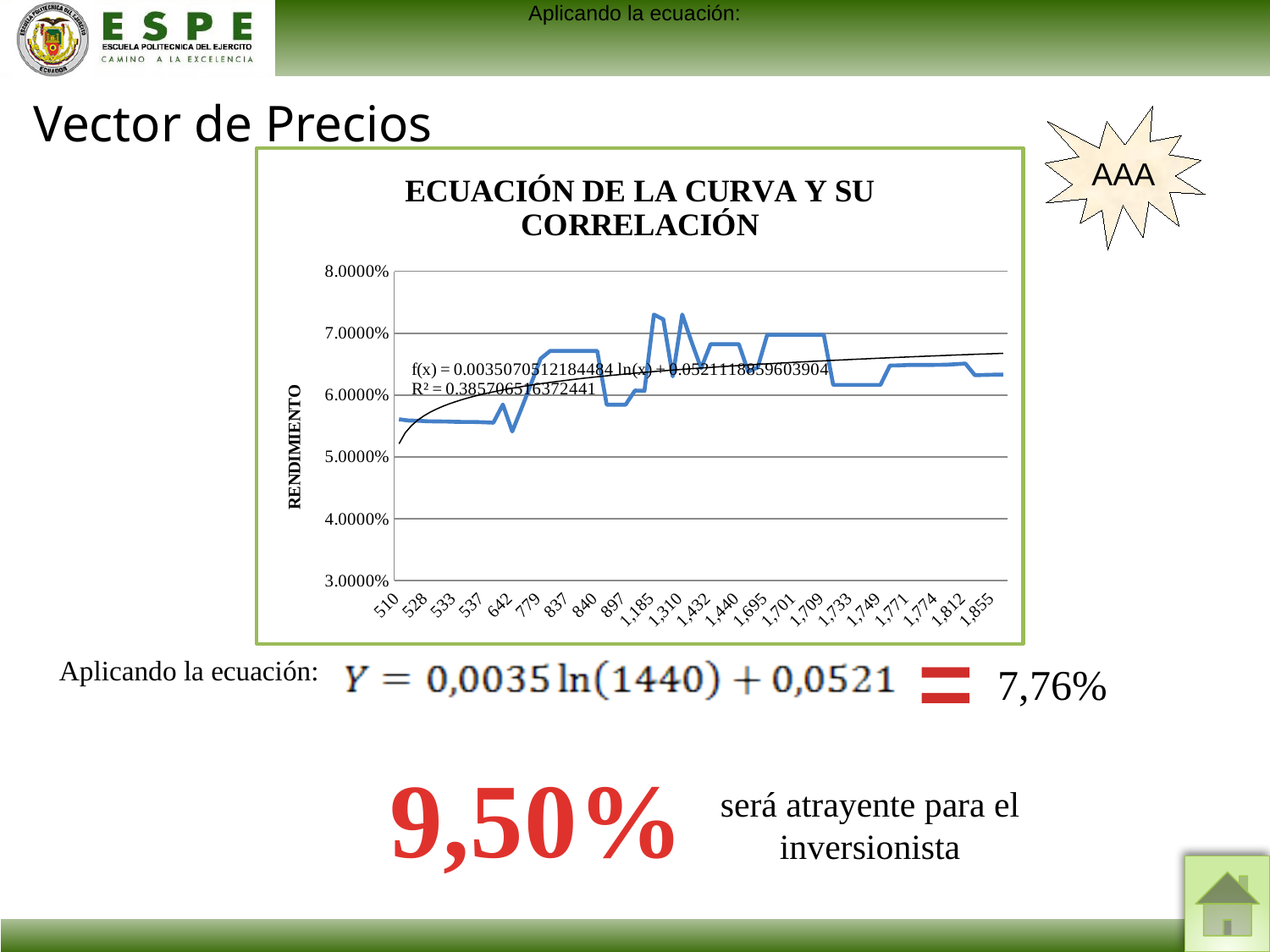
What kind of chart is shown on the slide? line chart What is the title of the chart? ECUACIÓN DE LA CURVA Y SU CORRELACIÓN Is the value for 897 greater or less than 6.0000%? less What R² value is printed on the chart? 0.385706516372441 What is the highest tick value shown on the vertical axis? 8.0000% What is the label of the vertical axis of the chart? RENDIMIENTO Is the value for 1,855 greater or less than 6.0000%? greater Is the value for 1,855 greater or less than 7.0000%? less Which has the larger value, 510 or 1,855? 1,855 Do the values generally rise or fall along the x axis? rise